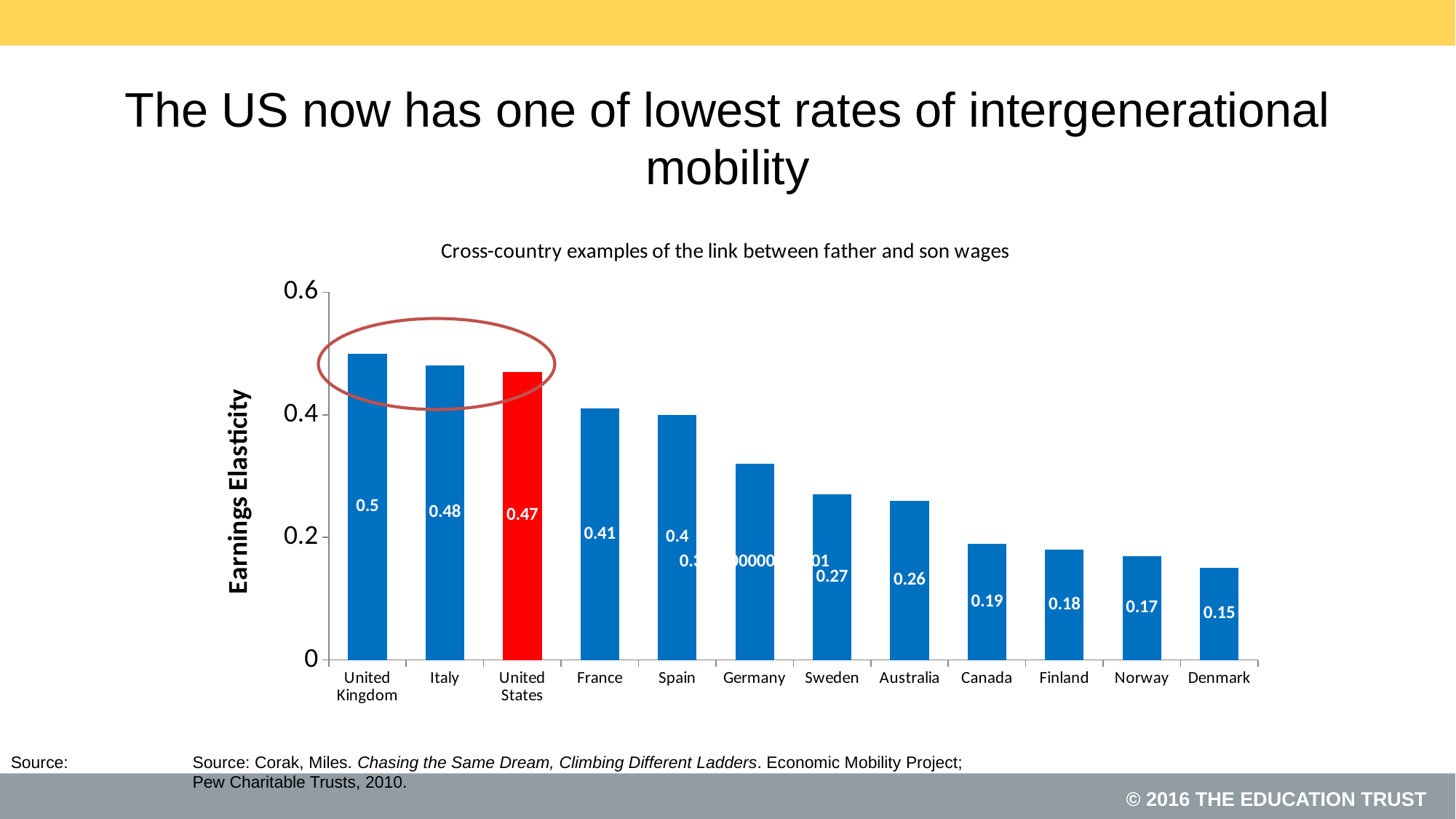
What is the earnings elasticity for the United States? 0.47 Which country has the highest earnings elasticity? United Kingdom What kind of chart is shown on the slide? Bar chart What is the earnings elasticity for the United Kingdom? 0.5 How many countries are shown in the chart? 12 Which country has the lowest earnings elasticity? Denmark What is the difference in earnings elasticity between the United Kingdom and Denmark? 0.35 Which country's bar is coloured red? United States What is the earnings elasticity for Canada? 0.19 Do the values rise or fall moving from left to right along the x axis? Fall Which has a higher earnings elasticity, France or Sweden? France Is the value for Germany greater or less than 0.4? less